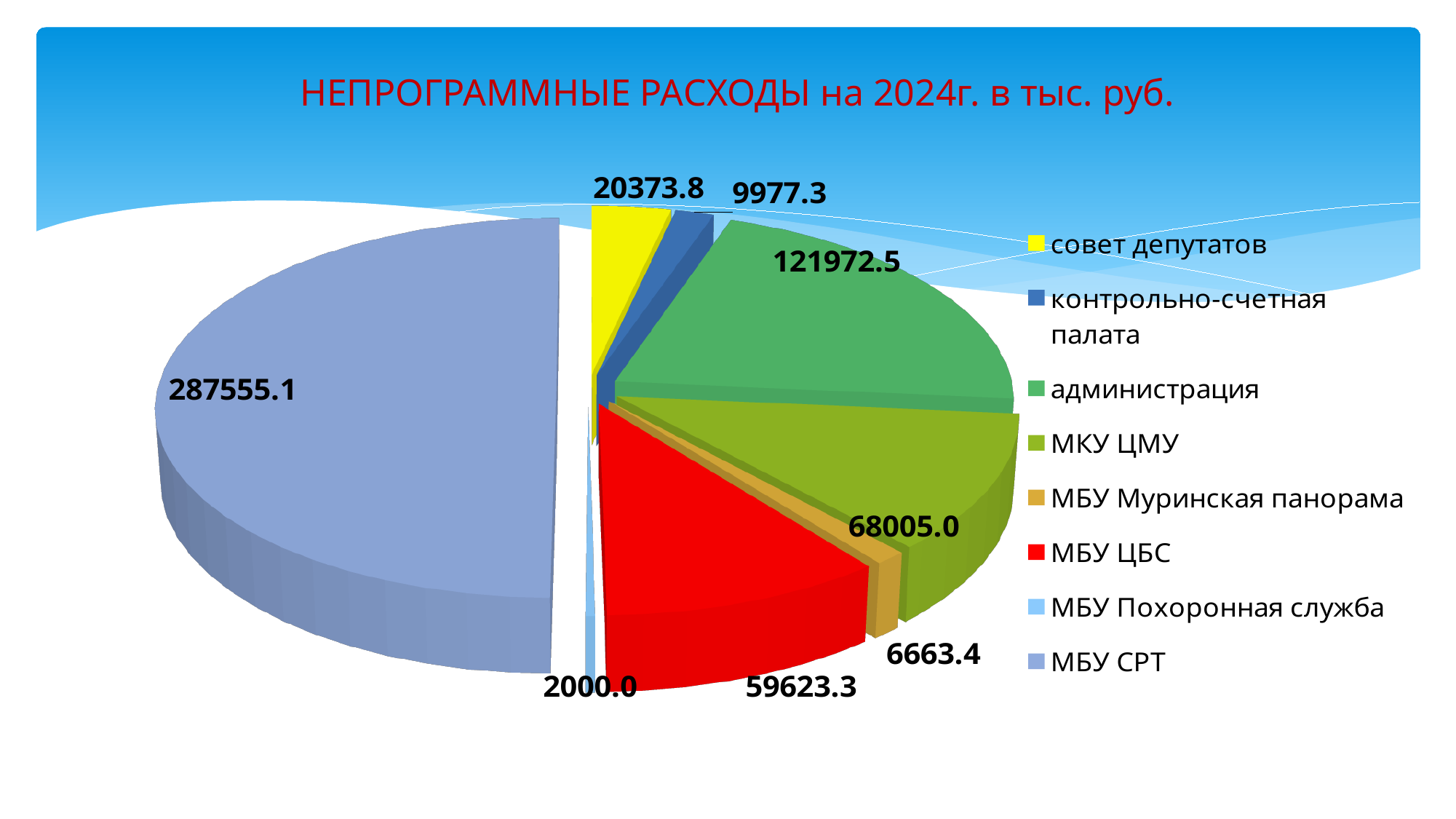
What is the title of the chart? НЕПРОГРАММНЫЕ РАСХОДЫ на 2024г. в тыс. руб. What is the value for МБУ ЦБС? 59623.3 What is the value for МБУ Муринская панорама? 6663.4 What type of chart is shown on the slide? pie chart Which category has the smallest value? МБУ Похоронная служба What is the value for администрация? 121972.5 Which is larger, the value for МКУ ЦМУ or the value for МБУ ЦБС? МКУ ЦМУ What is the difference between the values for совет депутатов and контрольно-счетная палата? 10396.5 What is the value for контрольно-счетная палата? 9977.3 How many categories does the pie chart have? 8 What is the difference between the values for администрация and МКУ ЦМУ? 53967.5 Which category has the largest value? МБУ СРТ